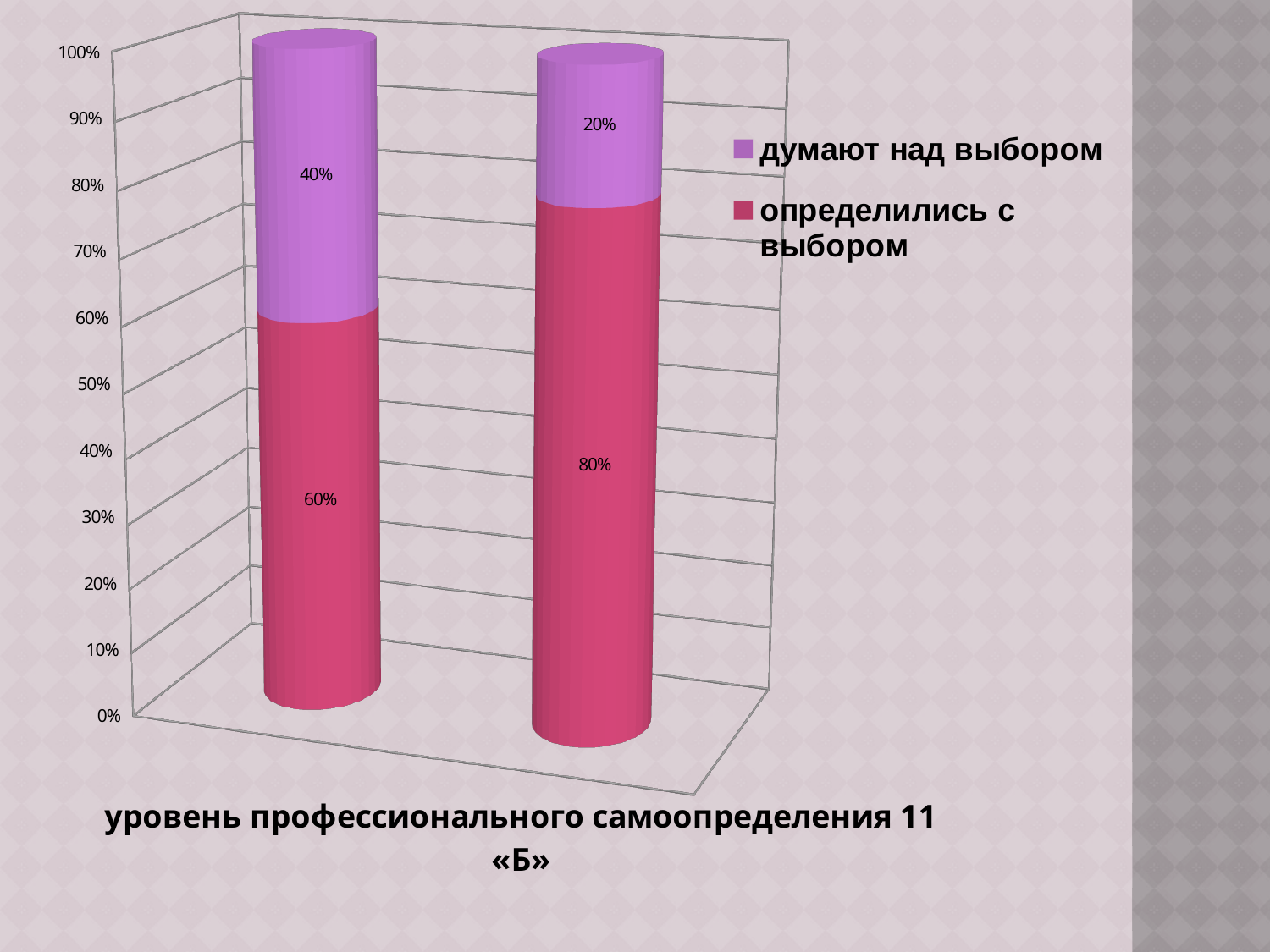
What is the difference between the 'определились с выбором' values of the right bar and the left bar? 20% How many bars are plotted in the chart? 2 How many series does the legend list? 2 Which bar has the larger 'думают над выбором' segment, the left or the right? left What is the value of the 'определились с выбором' segment in the left bar? 60% Which legend entry is shown in purple? думают над выбором What is the value of the 'определились с выбором' segment in the right bar? 80% What is the value of the 'думают над выбором' segment in the right bar? 20% What is the total of the stacked segments in the right bar? 100% What kind of chart is shown on the slide? stacked bar chart What is the title of the chart? уровень профессионального самоопределения 11 «Б» What is the value of the 'думают над выбором' segment in the left bar? 40%